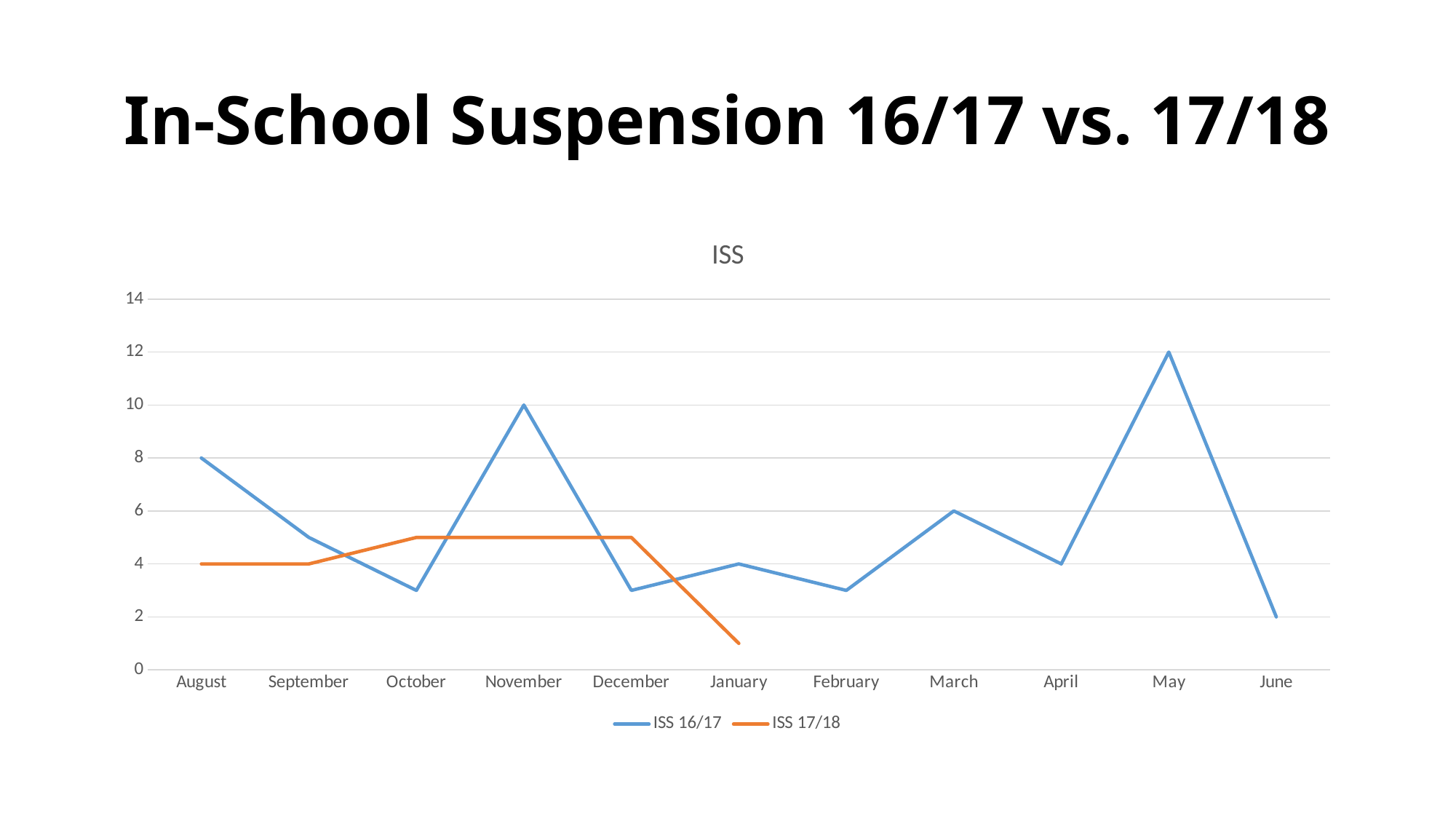
What is the ISS 16/17 value for November? 10 What is the ISS 17/18 value for August? 4 Which is larger, the ISS 16/17 value for August or for November? November Does the ISS 16/17 line rise or fall from May to June? Fall What type of chart is shown on the slide? Line chart What is the ISS 16/17 value for May? 12 How many series does the legend list? 2 How many months are shown on the x axis? 11 In which month is the ISS 16/17 value lowest? June What is the difference between the ISS 16/17 values for May and November? 2 Is the ISS 17/18 value for January greater or less than 2? less In which month is the ISS 16/17 value highest? May